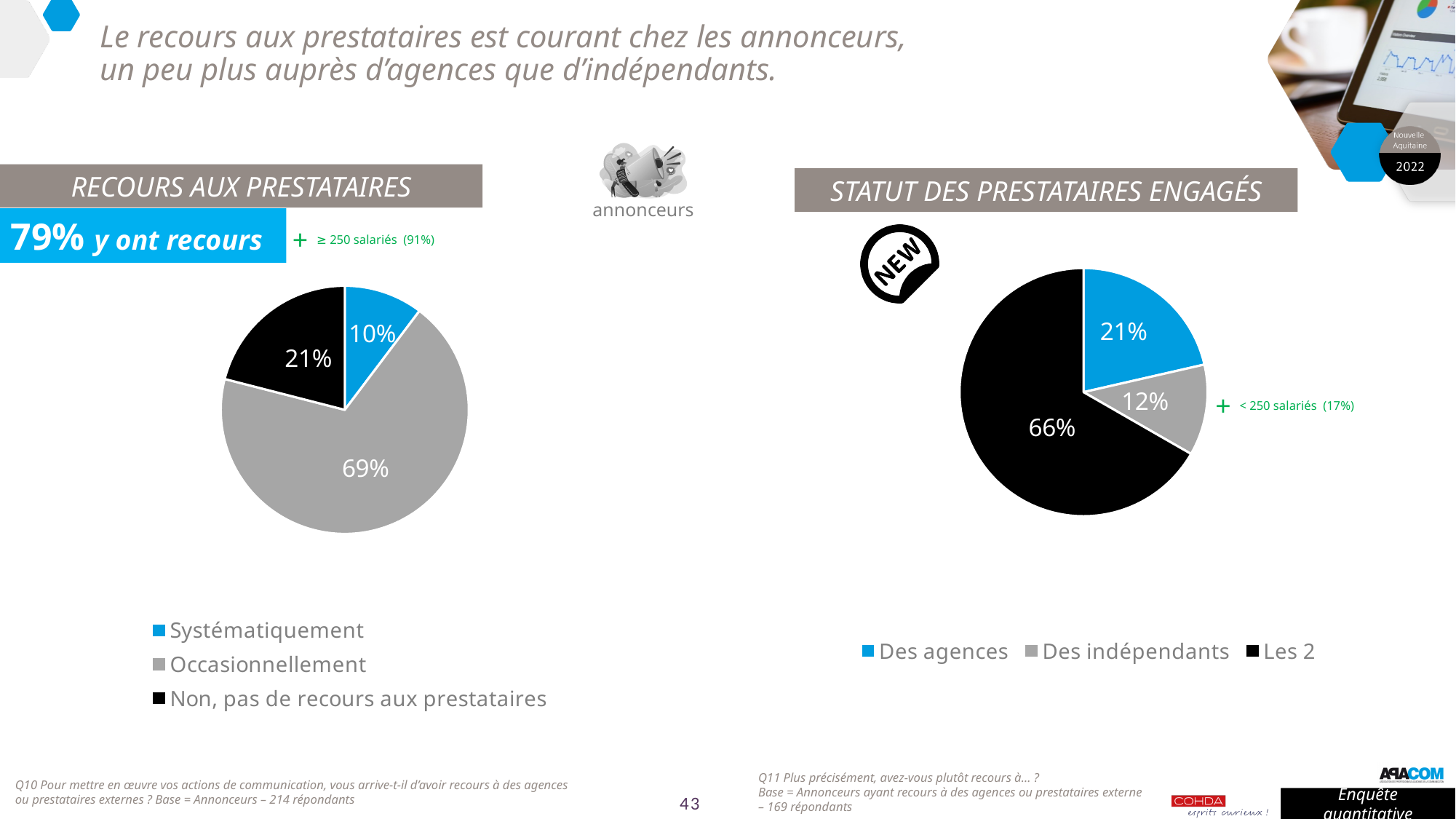
In the 'RECOURS AUX PRESTATAIRES' pie chart, which category has the smallest share? Systématiquement In the 'RECOURS AUX PRESTATAIRES' pie chart, what is the value for 'Non, pas de recours aux prestataires'? 21% In the 'RECOURS AUX PRESTATAIRES' pie chart, what is the difference between 'Occasionnellement' and 'Non, pas de recours aux prestataires'? 48% In the 'STATUT DES PRESTATAIRES ENGAGÉS' pie chart, what is the value for 'Des agences'? 21% In the 'RECOURS AUX PRESTATAIRES' pie chart, which category has the largest share? Occasionnellement In the 'STATUT DES PRESTATAIRES ENGAGÉS' pie chart, what is the value for 'Les 2'? 66% How many categories does the legend of the 'STATUT DES PRESTATAIRES ENGAGÉS' chart list? 3 In the 'STATUT DES PRESTATAIRES ENGAGÉS' pie chart, what is the value for 'Des indépendants'? 12% In the 'STATUT DES PRESTATAIRES ENGAGÉS' pie chart, which is larger, 'Des agences' or 'Des indépendants'? Des agences What kind of chart is used under 'RECOURS AUX PRESTATAIRES'? Pie chart In the 'RECOURS AUX PRESTATAIRES' pie chart, what is the value for 'Occasionnellement'? 69% In the 'RECOURS AUX PRESTATAIRES' pie chart, what is the value for 'Systématiquement'? 10%